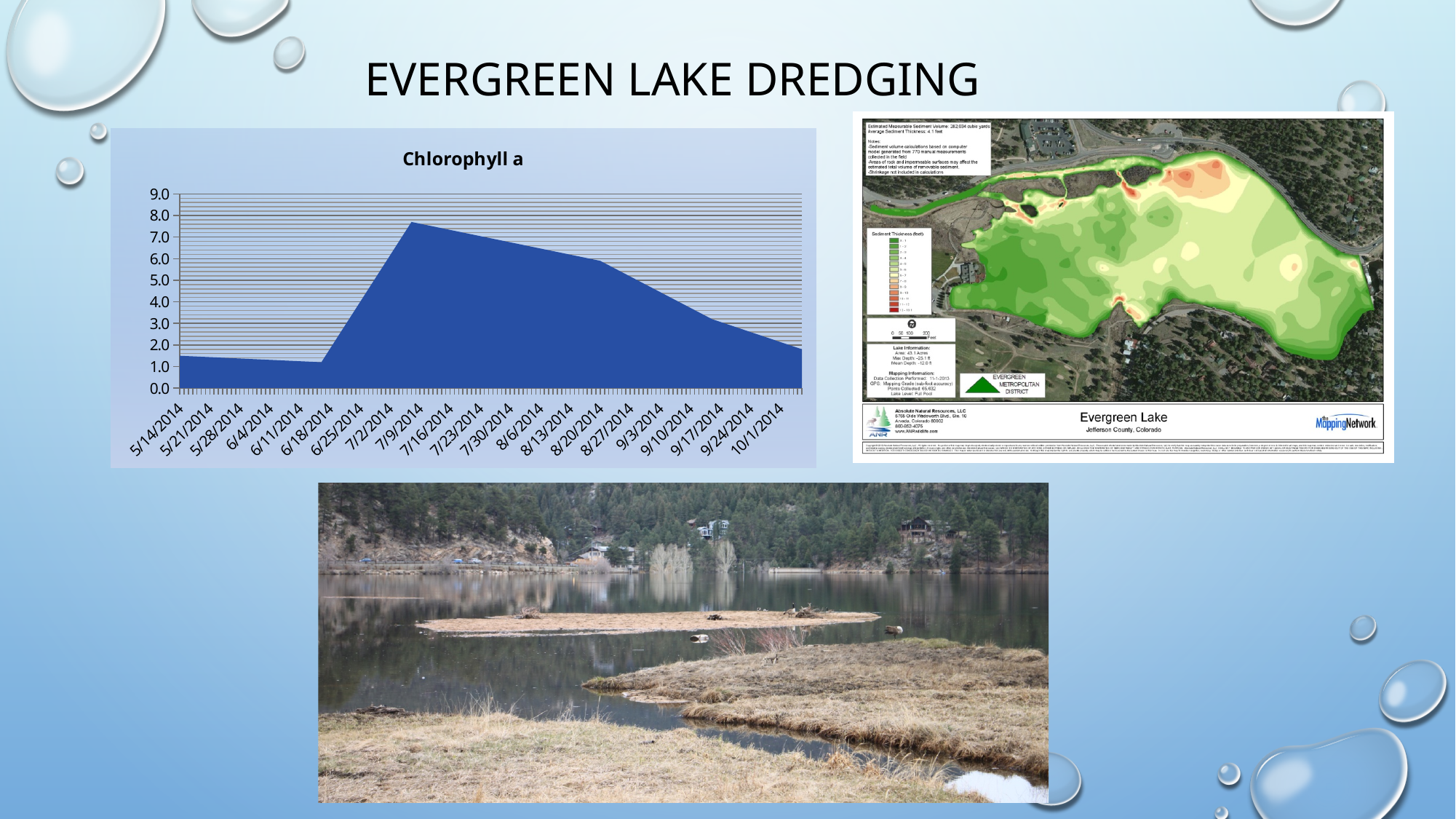
Which date has the larger Chlorophyll a value, 8/6/2014 or 9/10/2014? 8/6/2014 What kind of chart is the Chlorophyll a chart? area chart Is the Chlorophyll a value for 8/6/2014 greater or less than 6.0? greater What is the highest tick value shown on the y axis of the Chlorophyll a chart? 9.0 How many dates are shown along the x axis of the Chlorophyll a chart? 21 Which date has the larger Chlorophyll a value, 7/9/2014 or 5/14/2014? 7/9/2014 Do the Chlorophyll a values rise or fall from 7/9/2014 to 10/1/2014? fall Is the Chlorophyll a value for 7/9/2014 greater or less than 7.0? greater What is the title of the chart on the slide? Chlorophyll a Is the Chlorophyll a value for 5/14/2014 greater or less than 2.0? less